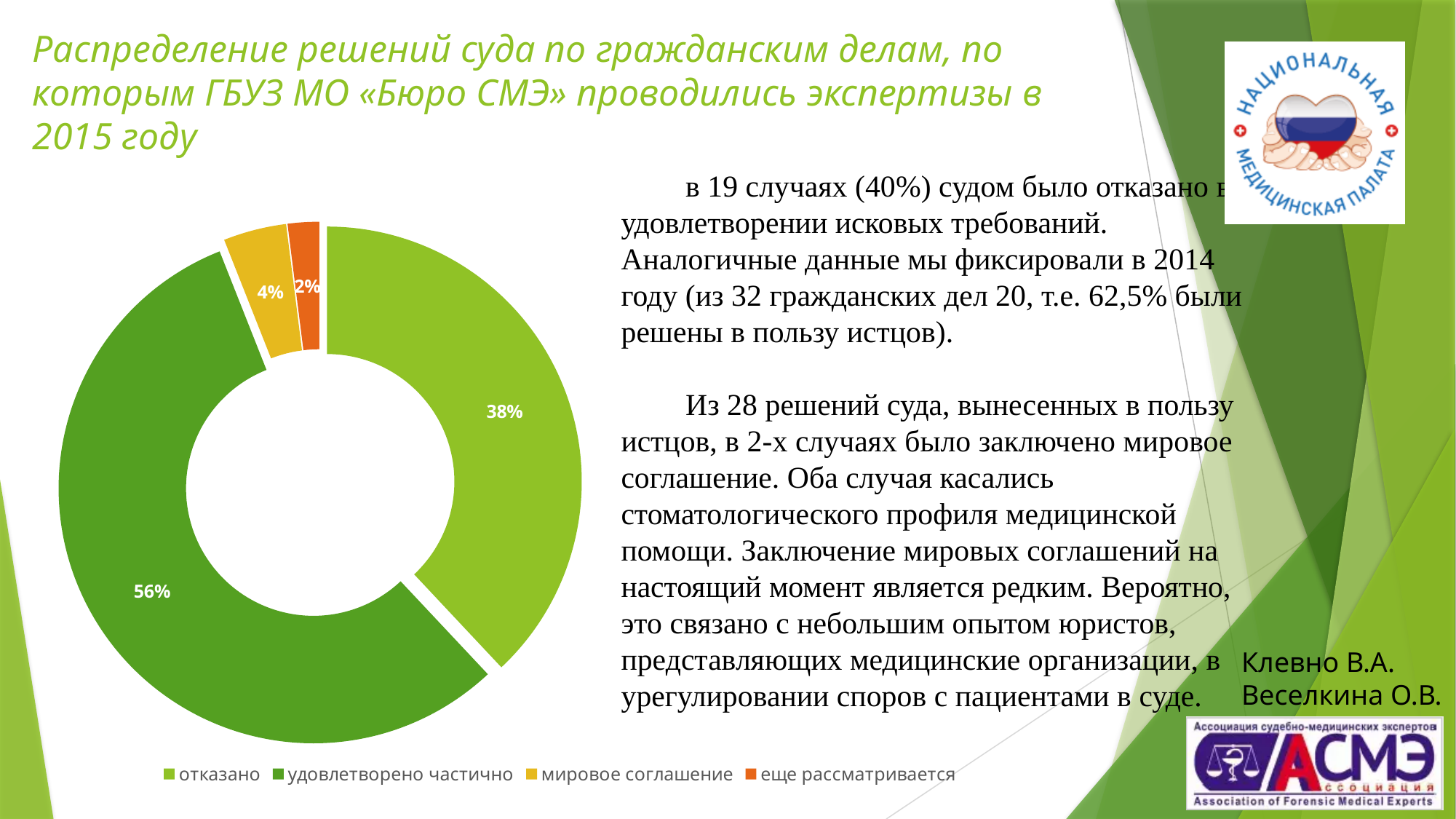
Which category has the largest share of the chart? удовлетворено частично What is the combined share of "мировое соглашение" and "еще рассматривается"? 6% What percentage is shown for "мировое соглашение"? 4% What percentage of the chart is labelled for the category "отказано"? 38% What colour represents "еще рассматривается" in the chart? Orange Which category has the smallest share of the chart? еще рассматривается What percentage is shown for "удовлетворено частично"? 56% What kind of chart is shown on the slide? Doughnut (pie) chart How many categories does the legend list? 4 Which is larger: the share for "мировое соглашение" or for "еще рассматривается"? мировое соглашение What percentage is shown for "еще рассматривается"? 2% What is the difference in percentage points between "удовлетворено частично" and "отказано"? 18 percentage points